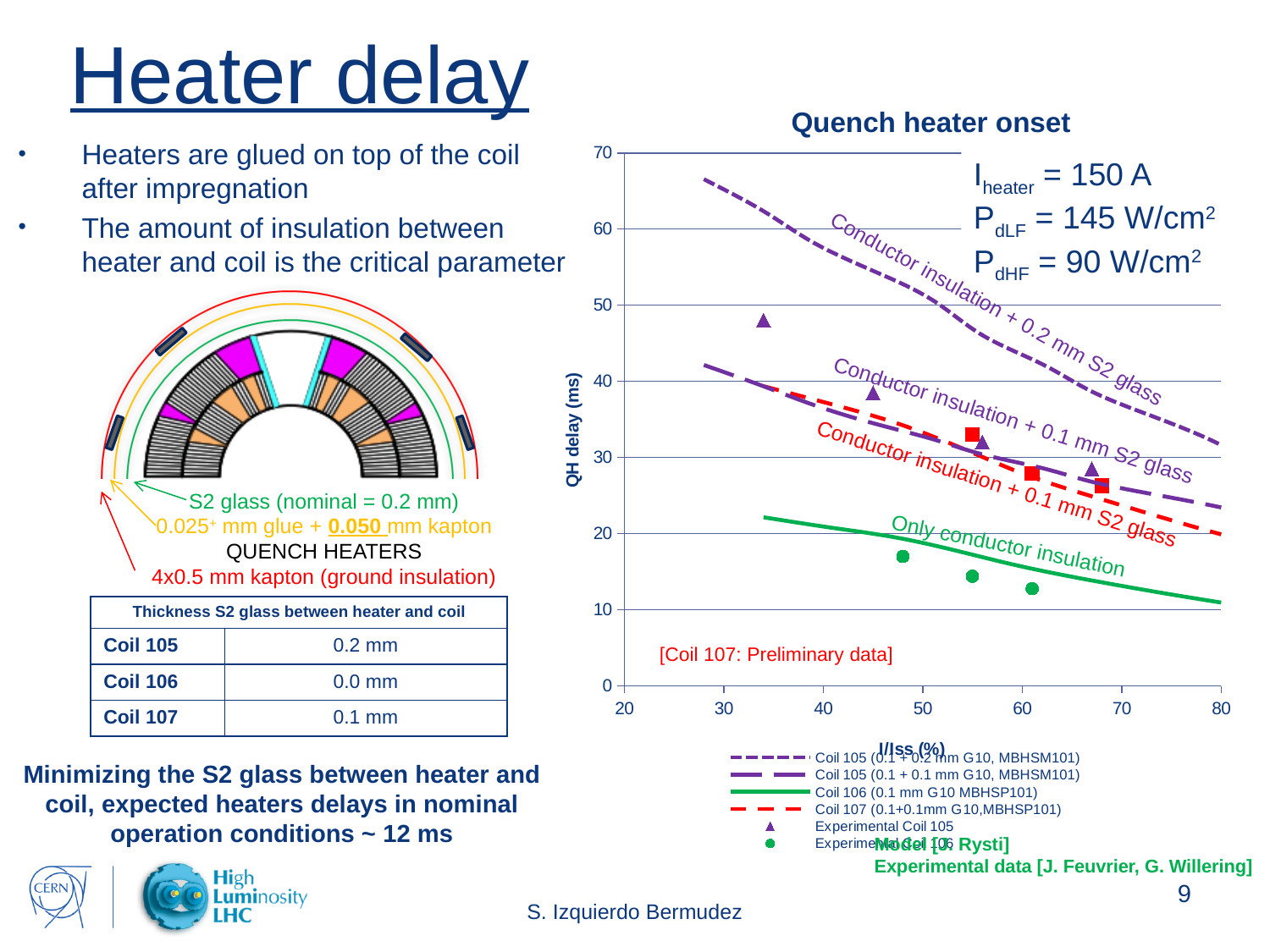
At I/Iss = 70%, which curve has the larger QH delay: 'Conductor insulation + 0.2 mm S2 glass' or 'Only conductor insulation'? Conductor insulation + 0.2 mm S2 glass Which model curve shows the lowest QH delay across the plotted range? Only conductor insulation How many series does the chart legend list? 6 What kind of chart is shown on the slide? line chart How many Experimental Coil 106 data points (green circles) are plotted on the chart? 3 Which model curve shows the highest QH delay across the plotted range? Conductor insulation + 0.2 mm S2 glass Do the model curves rise or fall as I/Iss (%) increases? fall Is the QH delay of the Experimental Coil 105 point near I/Iss = 34% greater or less than 50? less What is the title of the chart on the slide? Quench heater onset Is the QH delay of the 'Conductor insulation + 0.2 mm S2 glass' curve at I/Iss = 30% greater or less than 60? greater What is the label of the vertical axis of the chart? QH delay (ms) Is the QH delay of the 'Only conductor insulation' curve at I/Iss = 80% greater or less than 20? less